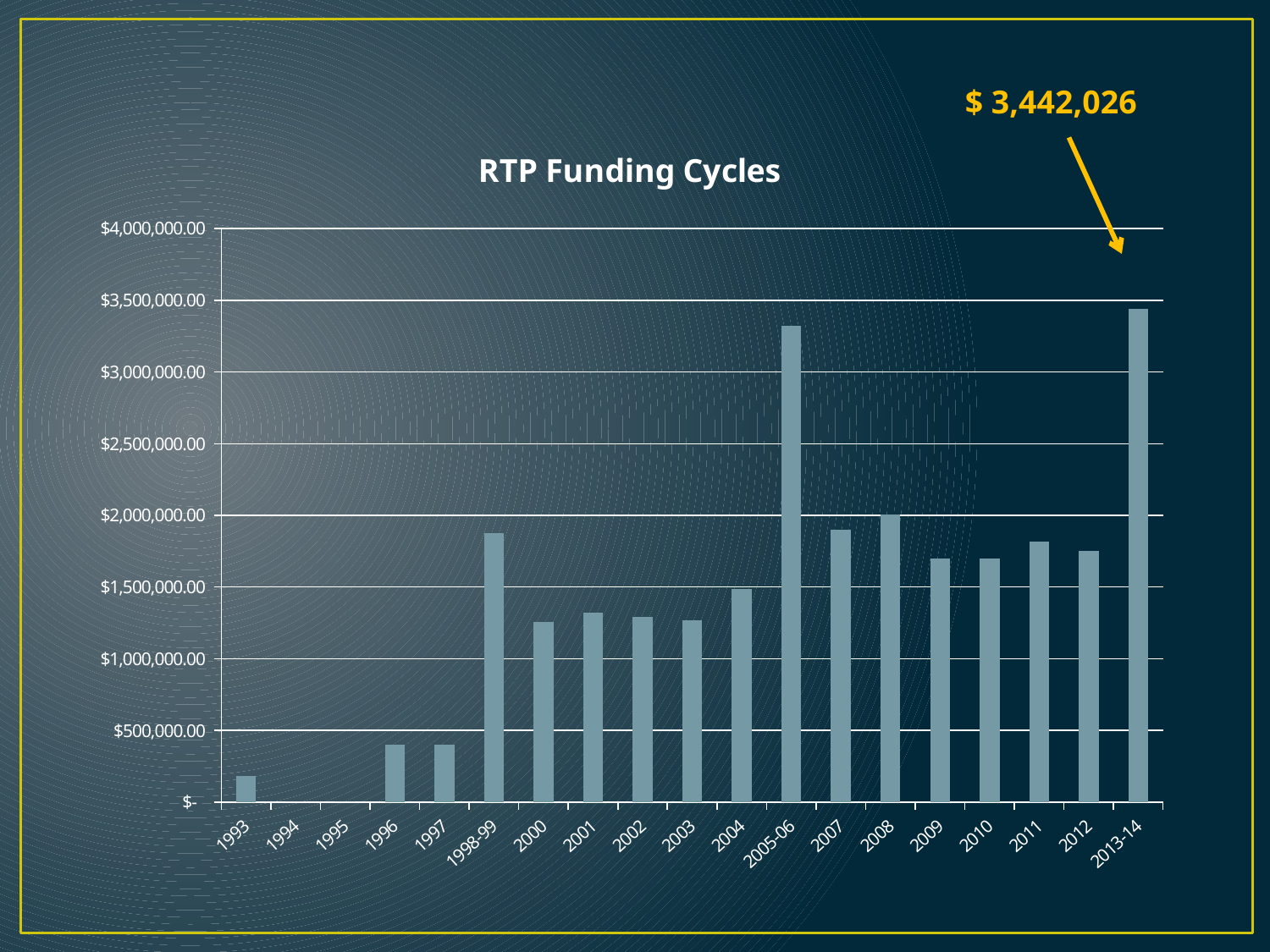
Is the value for 2005-06 greater or less than $3,000,000.00? greater Which is larger, the value for 2005-06 or the value for 2007? 2005-06 How many funding cycles are listed along the x axis? 19 What is the title of the chart? RTP Funding Cycles Which is larger, the value for 1996 or the value for 1993? 1996 Which is larger, the value for 1998-99 or the value for 2000? 1998-99 Which funding cycle has the highest value? 2013-14 What value is labelled for the 2013-14 funding cycle? $ 3,442,026 What type of chart is shown on the slide? bar chart Is the value for 1998-99 greater or less than $1,500,000.00? greater Is the value for 2000 greater or less than $1,500,000.00? less